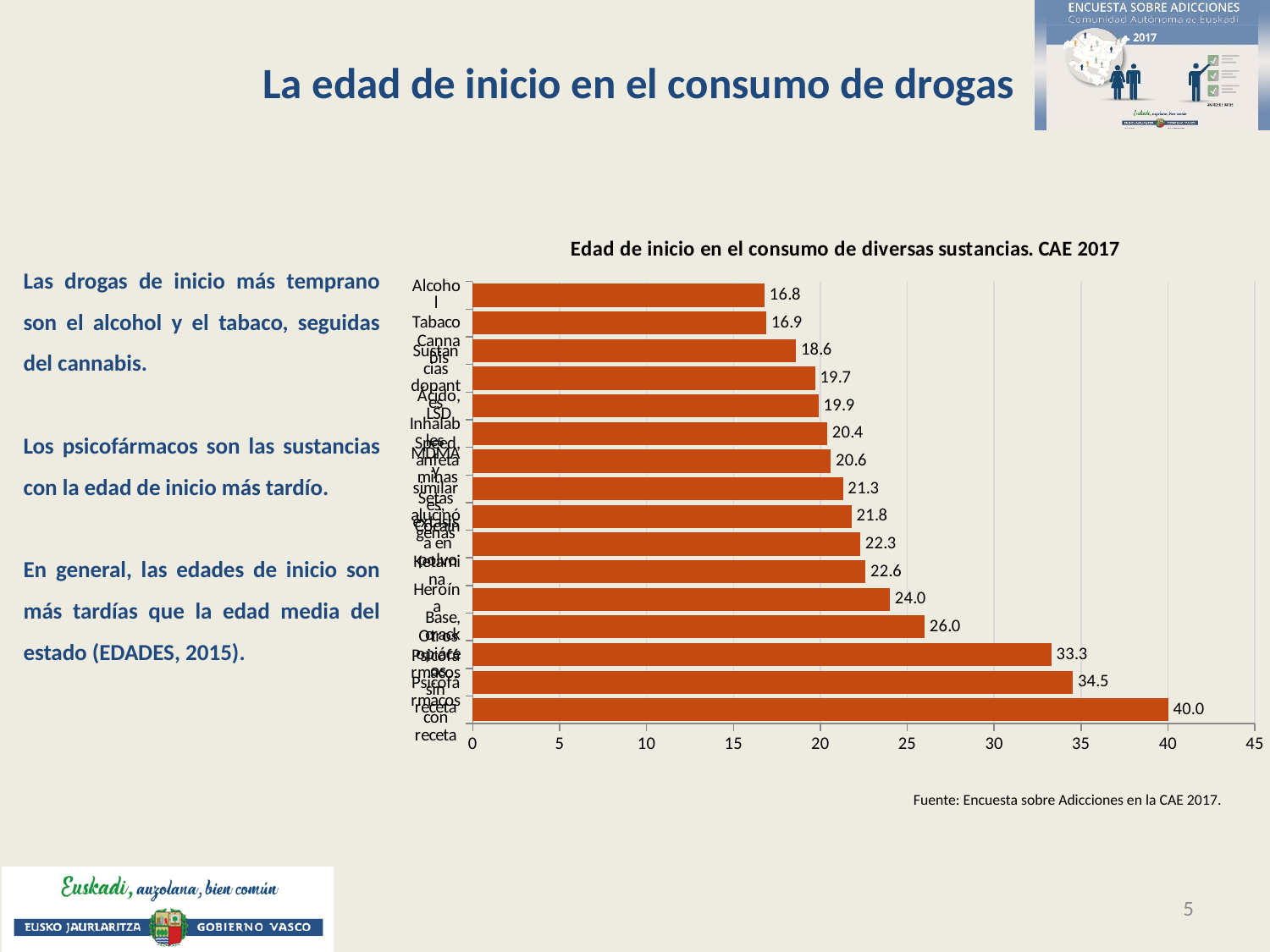
Which substance has the lowest age of first use? Alcohol What is the age of first use shown for Tabaco? 16.9 What is the value of the longest bar in the chart? 40.0 What value is shown for Cannabis? 18.6 How many bars does the chart contain? 16 What is the age of first use shown for Alcohol? 16.8 Which is larger, the value for Heroína or the value for Cannabis? Heroína What is the difference between the values for Heroína and Cannabis? 5.4 What value is shown for Heroína? 24.0 What type of chart is shown on the slide? Bar chart Is the value for Heroína greater or less than 20? greater What is the difference between the values for Tabaco and Alcohol? 0.1